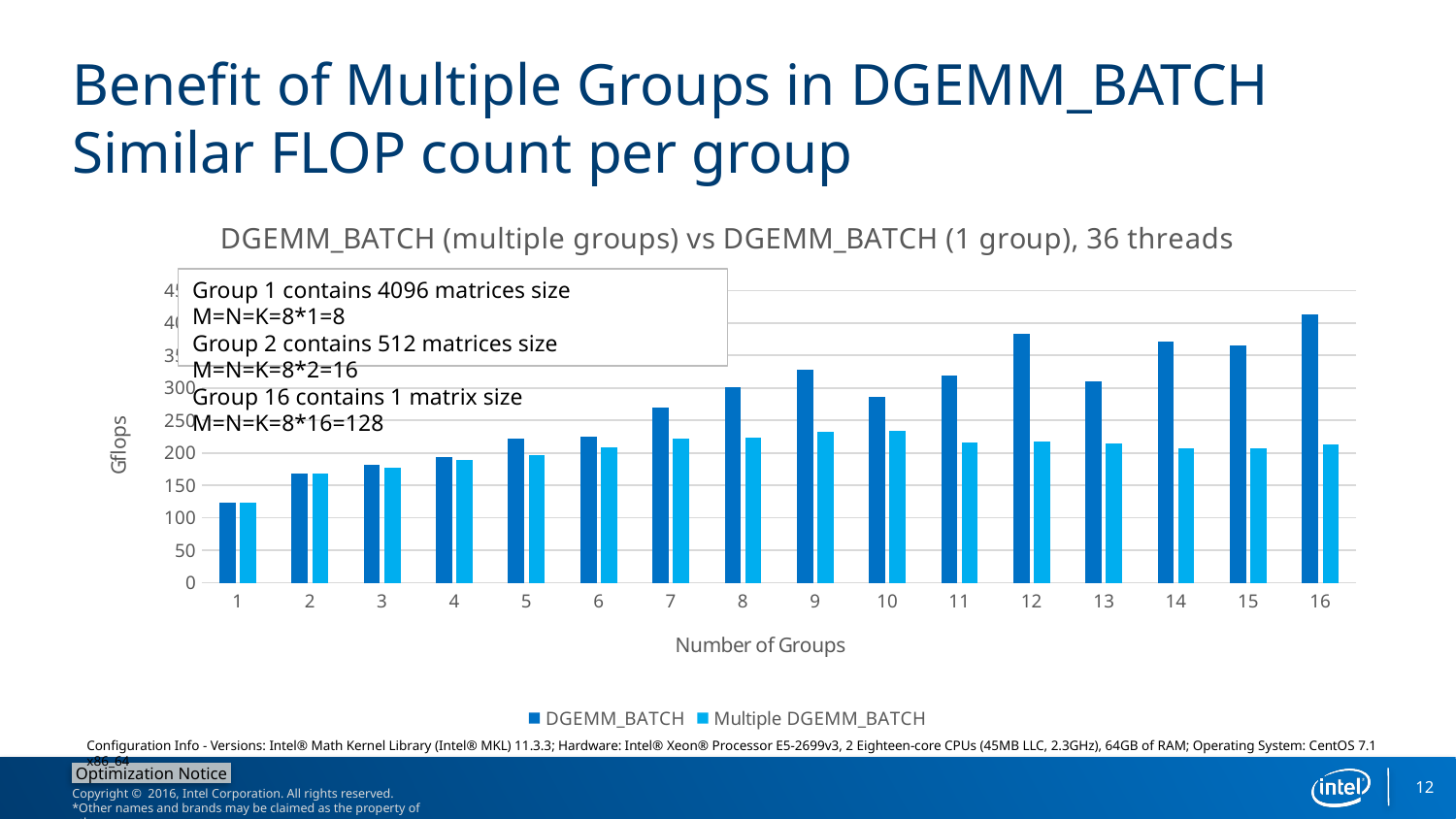
At 16 groups, which series has the larger value, DGEMM_BATCH or Multiple DGEMM_BATCH? DGEMM_BATCH How many series does the chart legend list? 2 Is the Multiple DGEMM_BATCH value for 10 groups greater or less than 250? less Is the DGEMM_BATCH value for 1 group greater or less than 150? less Do the DGEMM_BATCH values generally rise or fall as the number of groups increases from 1 to 16? rise Is the DGEMM_BATCH value for 12 groups greater or less than 350? greater How many Number of Groups categories are plotted on the x axis? 16 What kind of chart is shown on the slide? bar chart For which number of groups is the DGEMM_BATCH value lowest? 1 For which number of groups is the DGEMM_BATCH value highest? 16 What is the label of the chart's y axis? Gflops